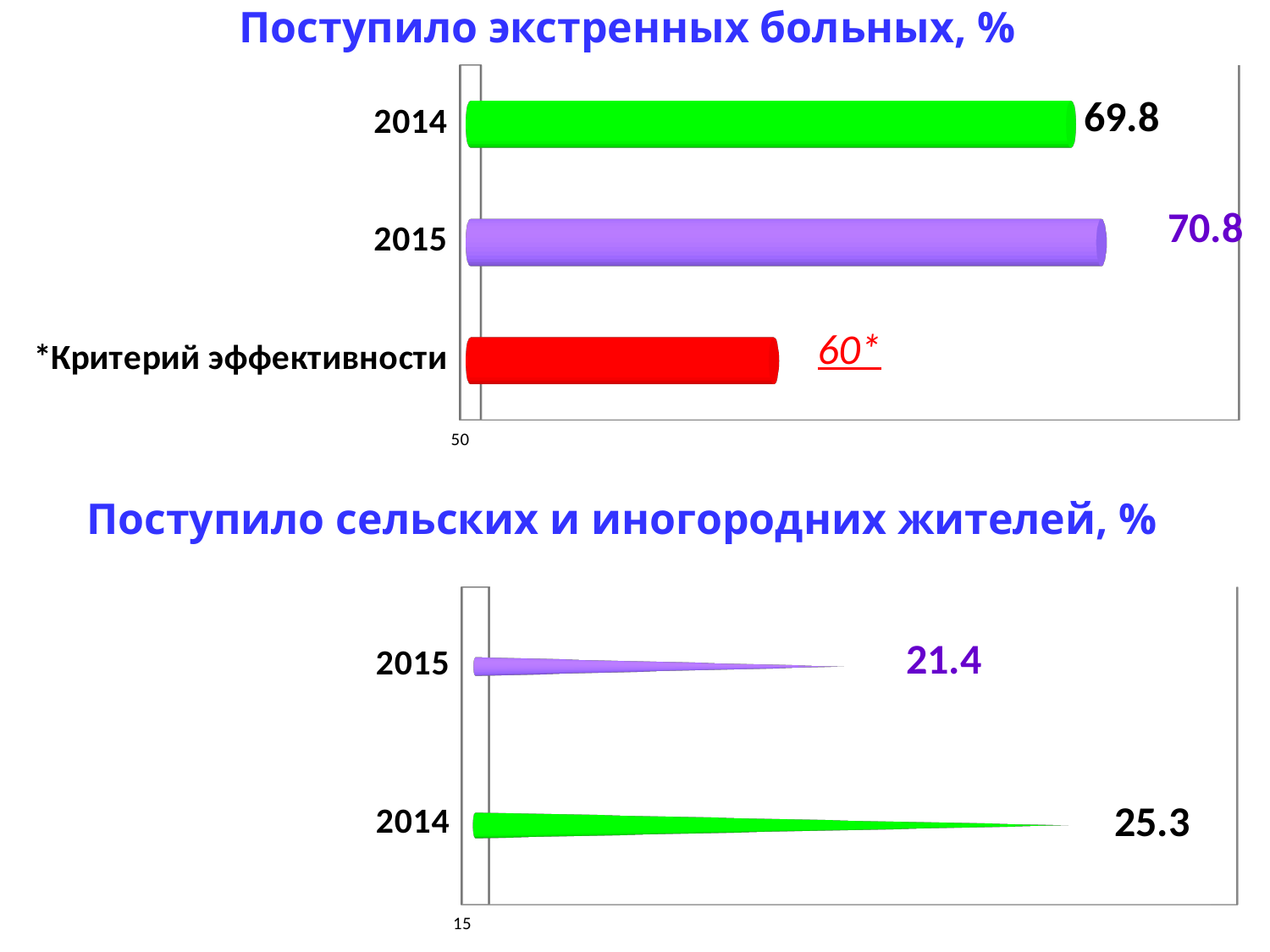
In the chart 'Поступило сельских и иногородних жителей, %', what is the value for 2014? 25.3 In the chart 'Поступило экстренных больных, %', what value is shown for '*Критерий эффективности'? 60* In the chart 'Поступило сельских и иногородних жителей, %', what is the difference between the 2014 and 2015 values? 3.9 What type of chart is the bottom chart on the slide? Bar chart In the chart 'Поступило сельских и иногородних жителей, %', which year has the higher value? 2014 In the chart 'Поступило сельских и иногородних жителей, %', what is the value for 2015? 21.4 In the chart 'Поступило экстренных больных, %', what colour is the bar for '*Критерий эффективности'? Red In the chart 'Поступило экстренных больных, %', what is the difference between the 2015 and 2014 values? 1.0 In the chart 'Поступило экстренных больных, %', what is the value for 2015? 70.8 In the chart 'Поступило экстренных больных, %', what is the value for 2014? 69.8 In the chart 'Поступило экстренных больных, %', how many bars are plotted? 3 In the chart 'Поступило экстренных больных, %', which category has the lowest value? *Критерий эффективности